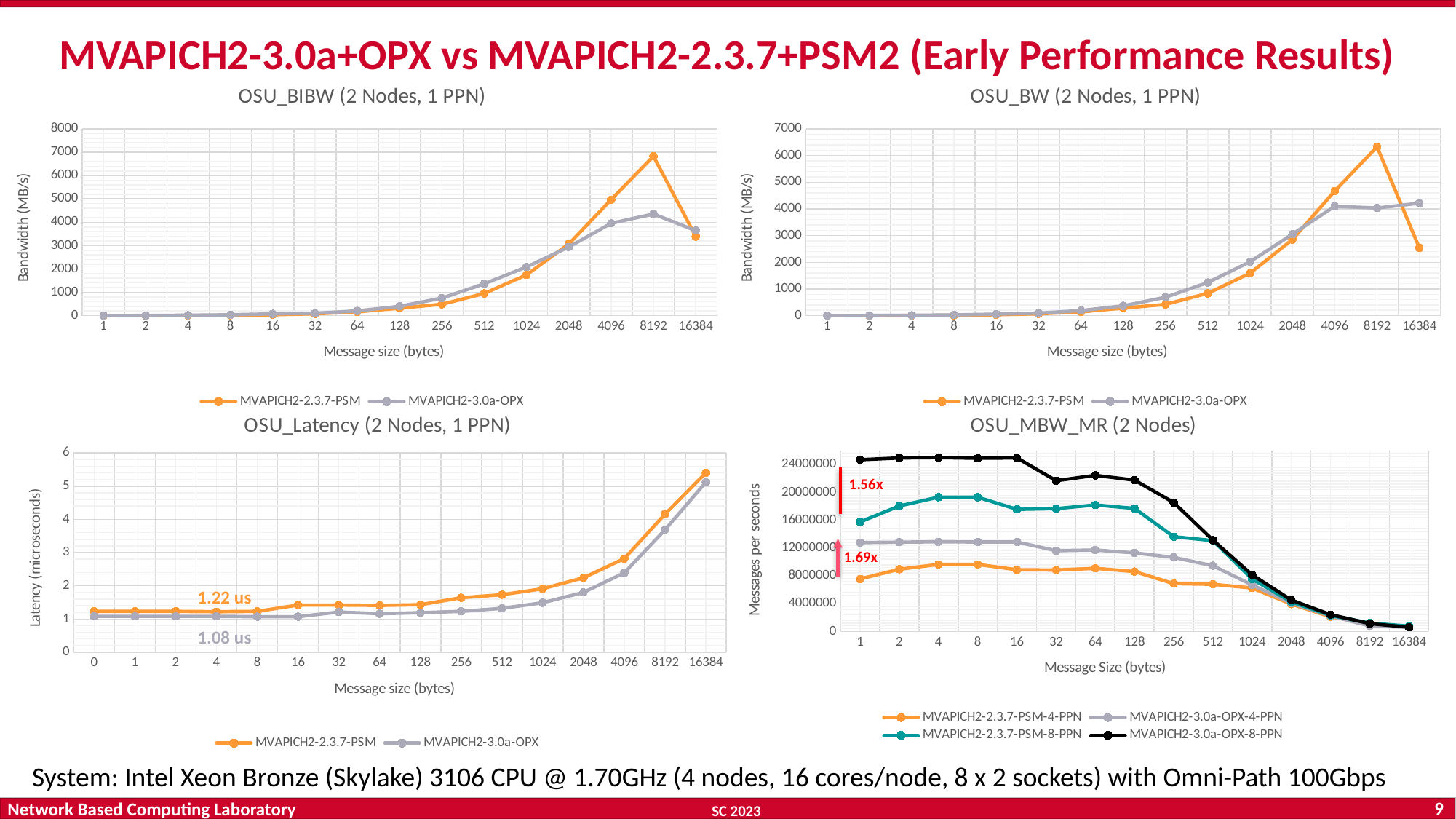
In the OSU_Latency (2 Nodes, 1 PPN) chart, what latency value is labelled for MVAPICH2-3.0a-OPX at small message sizes? 1.08 us In the OSU_MBW_MR (2 Nodes) chart, what speedup is annotated between the 8-PPN series at the left of the chart? 1.56x In the OSU_Latency (2 Nodes, 1 PPN) chart, what latency value is labelled for MVAPICH2-2.3.7-PSM at small message sizes? 1.22 us In the OSU_MBW_MR (2 Nodes) chart, which series has the highest message rate at message size 1? MVAPICH2-3.0a-OPX-8-PPN In the OSU_Latency (2 Nodes, 1 PPN) chart, is the latency for MVAPICH2-2.3.7-PSM at message size 16384 greater or less than 5? greater In the OSU_BW (2 Nodes, 1 PPN) chart, is the bandwidth for MVAPICH2-2.3.7-PSM at message size 16384 greater or less than 3000? less How many message sizes are shown on the x axis of the OSU_Latency (2 Nodes, 1 PPN) chart? 16 What kind of chart is the OSU_BIBW (2 Nodes, 1 PPN) chart? line chart In the OSU_BIBW (2 Nodes, 1 PPN) chart, is the bandwidth for MVAPICH2-2.3.7-PSM at message size 8192 greater or less than 6000? greater How many series does the legend of the OSU_MBW_MR (2 Nodes) chart list? 4 In the OSU_BIBW (2 Nodes, 1 PPN) chart, which series has the higher bandwidth at message size 8192? MVAPICH2-2.3.7-PSM In the OSU_BW (2 Nodes, 1 PPN) chart, which series has the higher bandwidth at message size 16384? MVAPICH2-3.0a-OPX